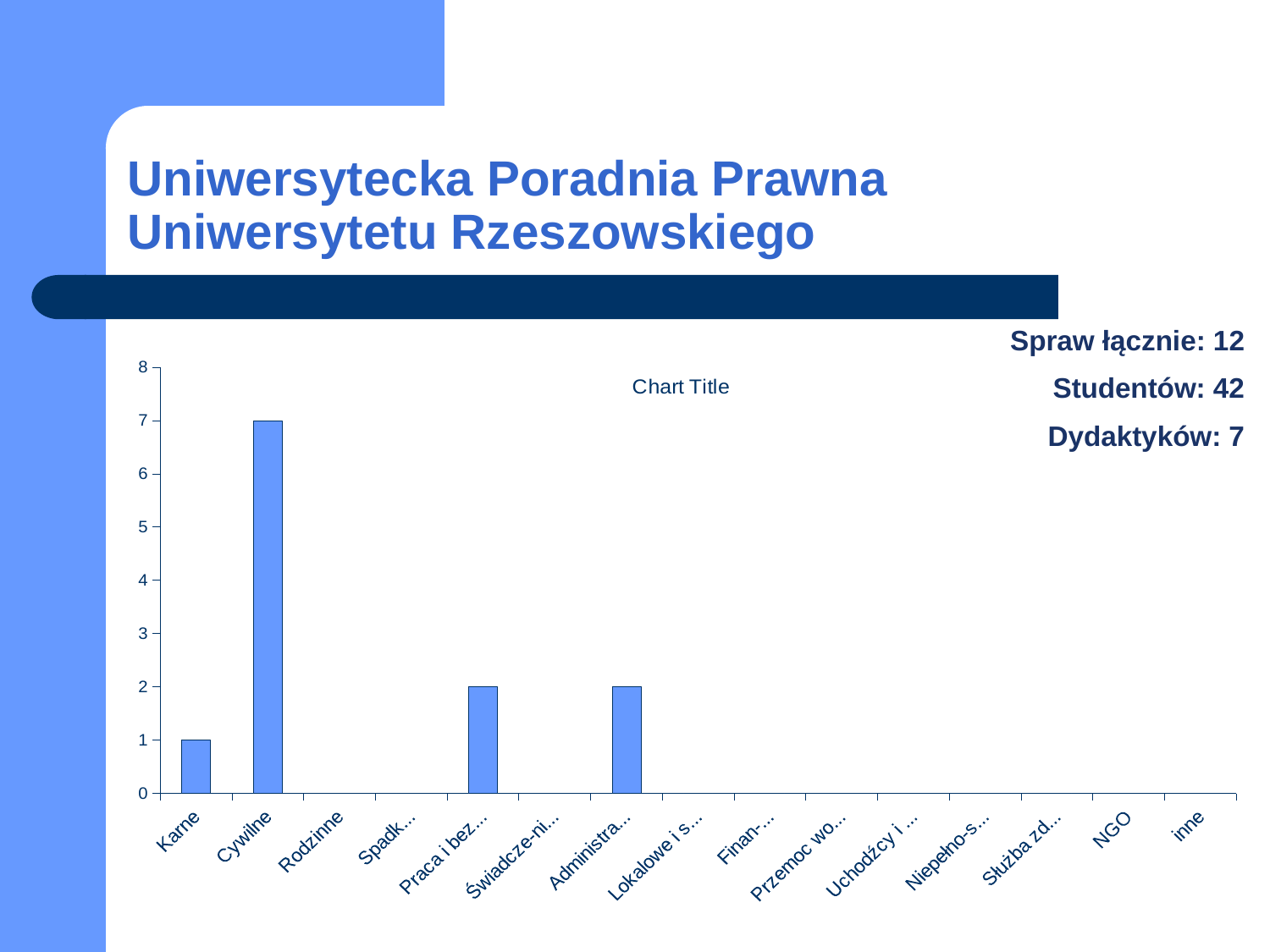
What is the highest value shown on the vertical axis? 8 How many categories are shown on the x axis? 15 What is the title shown on the chart? Chart Title What kind of chart is shown on the slide? Bar chart What is the value for Karne? 1 What is the difference between the values for Cywilne and Karne? 6 Is the value for Cywilne greater or less than 5? greater What is the value for Rodzinne? 0 Which is larger, the value for Cywilne or the value for Karne? Cywilne Which category has the highest value? Cywilne What is the value for Cywilne? 7 What is the value for NGO? 0